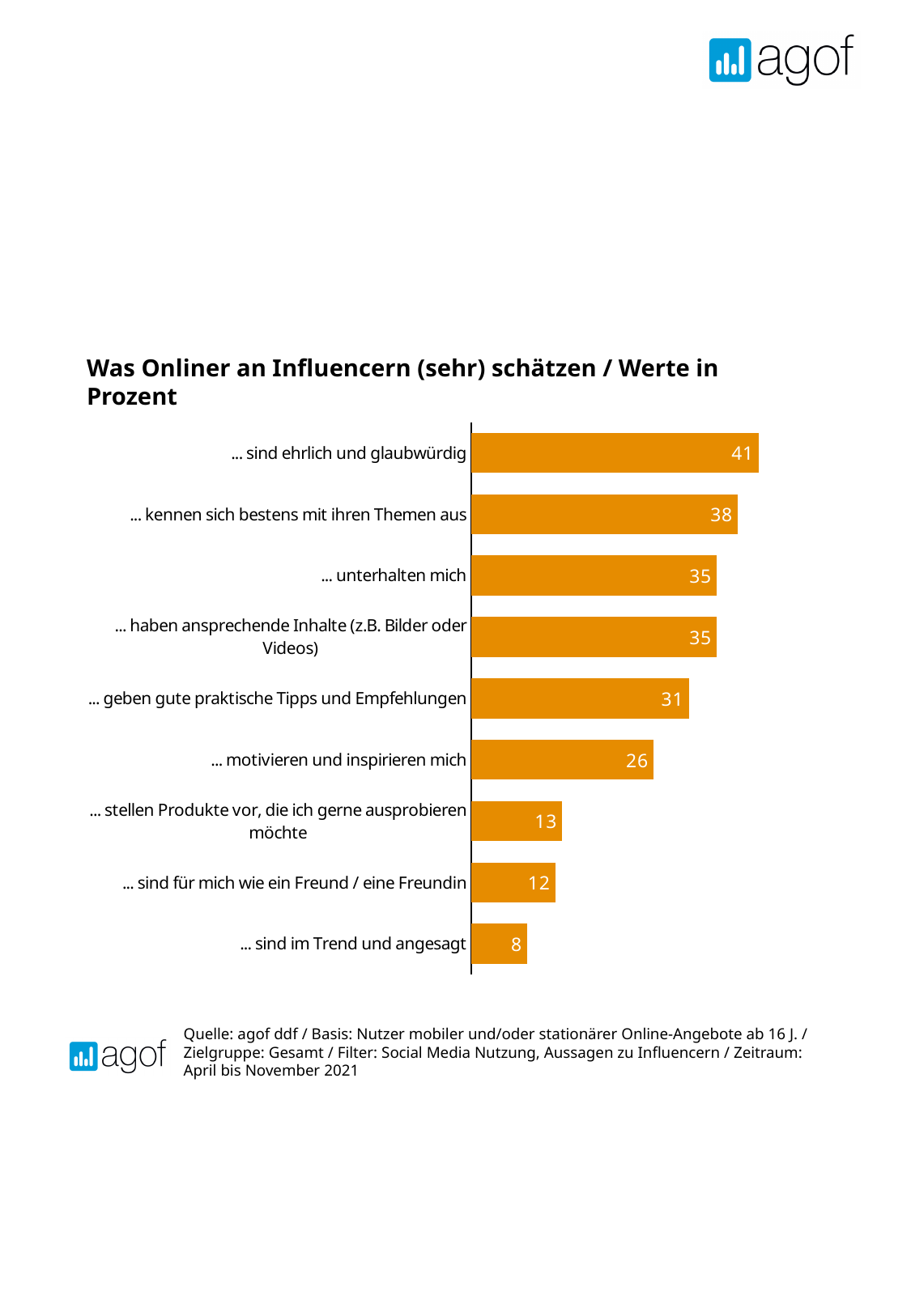
What is the difference between the values for "... stellen Produkte vor, die ich gerne ausprobieren möchte" and "... sind im Trend und angesagt"? 5 What colour are the bars in the chart? Orange Which category has the lowest value? ... sind im Trend und angesagt What kind of chart is shown on the slide? Bar chart Which category has the highest value? ... sind ehrlich und glaubwürdig What is the value for "... sind für mich wie ein Freund / eine Freundin"? 12 What is the value for "... motivieren und inspirieren mich"? 26 What is the value for "... sind ehrlich und glaubwürdig"? 41 How many categories are shown in the chart? 9 What is the title of the chart? Was Onliner an Influencern (sehr) schätzen / Werte in Prozent What is the difference between the values for "... kennen sich bestens mit ihren Themen aus" and "... geben gute praktische Tipps und Empfehlungen"? 7 Which is larger: the value for "... unterhalten mich" or the value for "... motivieren und inspirieren mich"? ... unterhalten mich